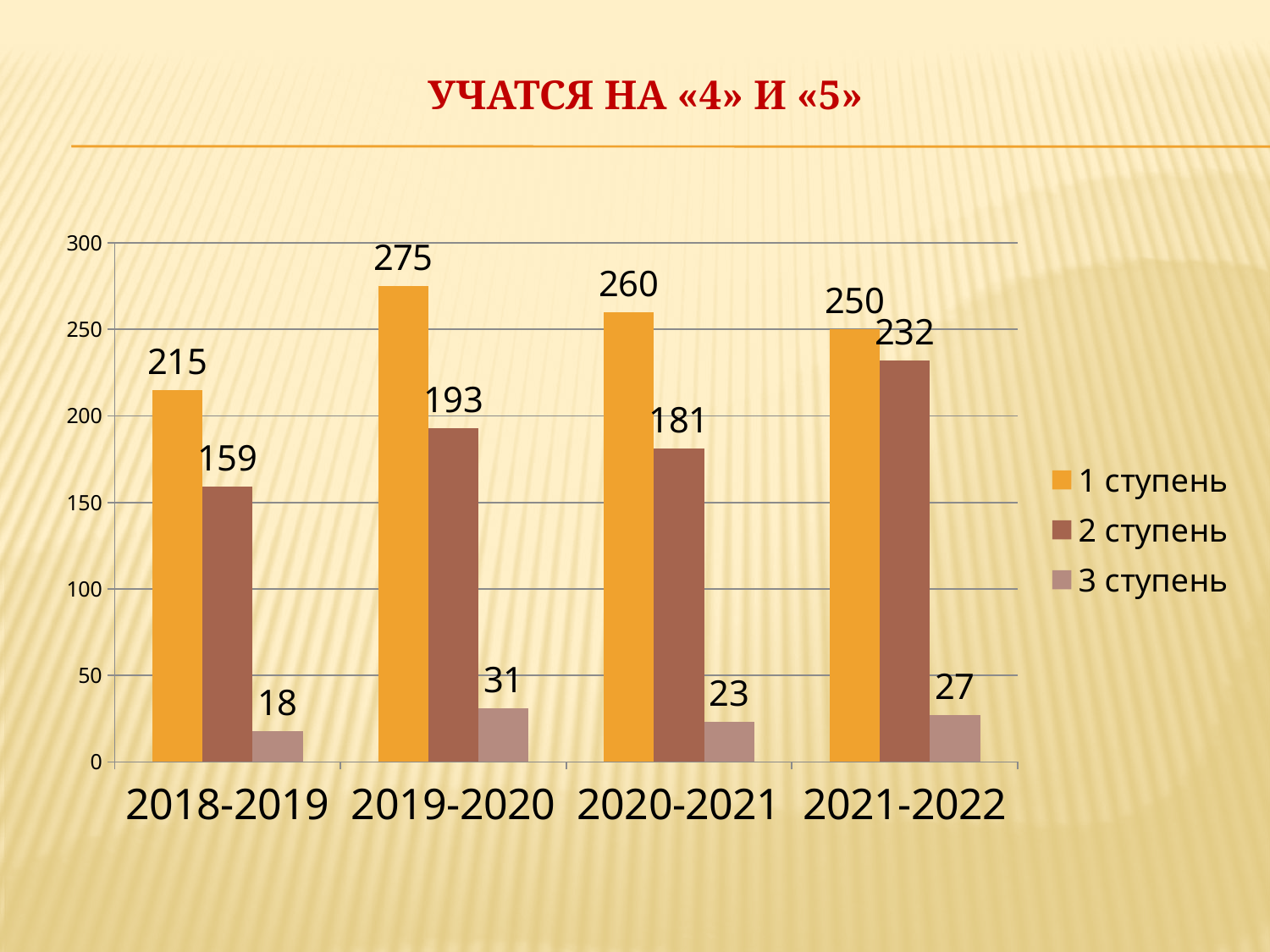
What is the value for 3 ступень in 2018-2019? 18 Does the value for 2 ступень rise or fall from 2020-2021 to 2021-2022? rise What kind of chart is shown on the slide? bar chart What is the value for 1 ступень in 2019-2020? 275 In which year is the value for 3 ступень lowest? 2018-2019 What is the difference between the 1 ступень values for 2019-2020 and 2018-2019? 60 Which is larger: 2 ступень in 2020-2021 or 2 ступень in 2019-2020? 2 ступень in 2019-2020 How many school years are shown on the x axis? 4 In which year is the value for 1 ступень highest? 2019-2020 How many series does the legend list? 3 Is the value for 1 ступень in 2021-2022 greater or less than 200? greater What is the value for 2 ступень in 2021-2022? 232